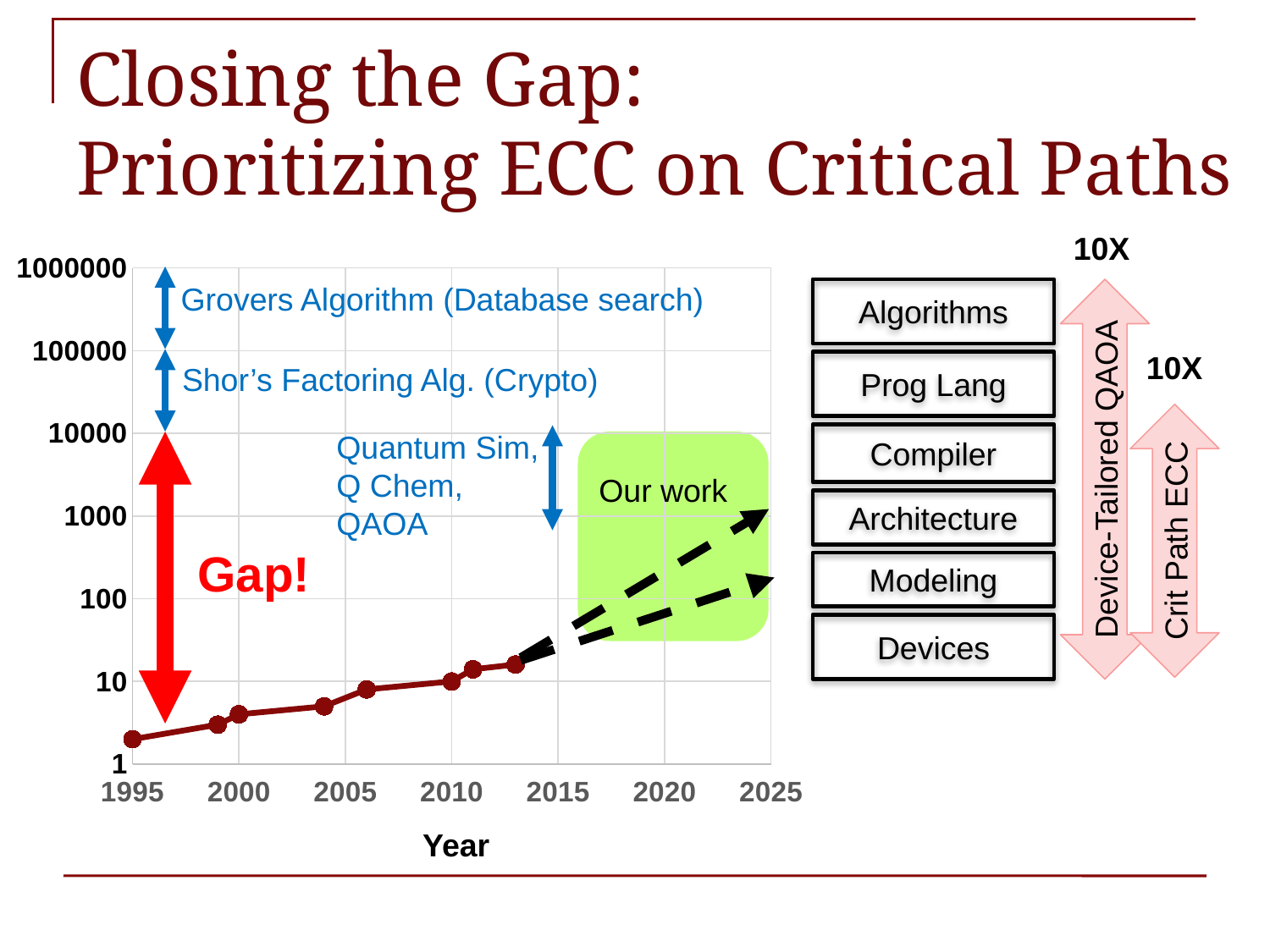
What is the title of the x axis of the chart? Year Is the plotted value for 2000 greater or less than 10? less Which plotted year has the lowest value on the line? 1995 What is the last year labelled on the x axis of the chart? 2025 Is the plotted value for 2011 greater or less than 100? less Is the plotted value for 1995 greater or less than 10? less Which year has the highest plotted value on the line, 1995 or 2013? 2013 What is the highest value labelled on the y axis of the chart? 1000000 Do the plotted values rise or fall as the year increases from 1995 to 2013? rise What kind of chart is shown on the left of the slide? line chart How many data points are plotted on the line in the chart? 8